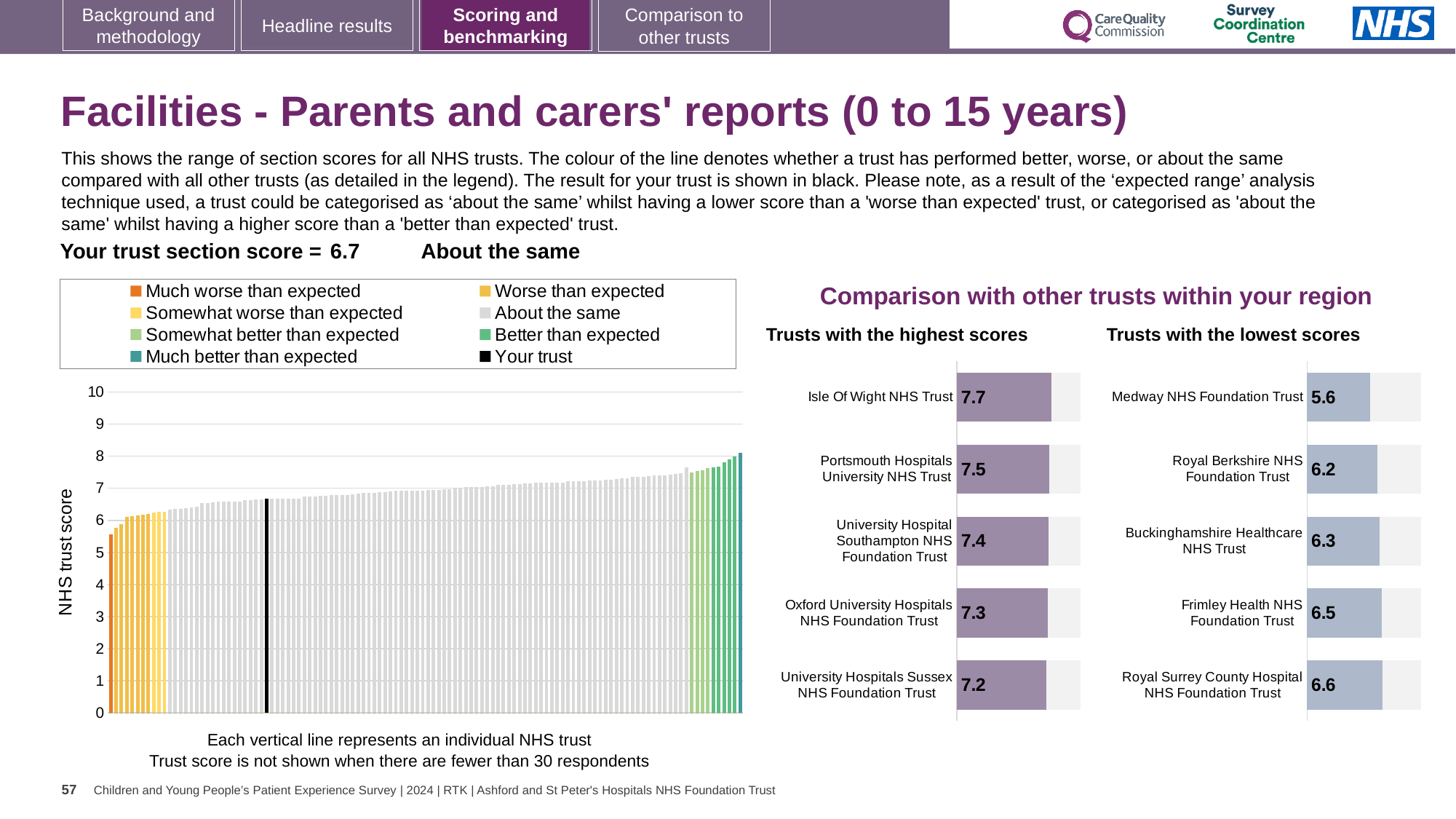
In the large chart on the left showing all NHS trusts, what is the section score for your trust (the black bar)? 6.7 In the 'Trusts with the highest scores' chart, what is the difference between the scores of Isle Of Wight NHS Trust and University Hospitals Sussex NHS Foundation Trust? 0.5 In the 'Trusts with the highest scores' chart, what is the score for Oxford University Hospitals NHS Foundation Trust? 7.3 In the 'Trusts with the lowest scores' chart, which trust has the lowest score? Medway NHS Foundation Trust In the 'Trusts with the highest scores' chart, which trust has the highest score? Isle Of Wight NHS Trust In the 'Trusts with the lowest scores' chart, what is the difference between the scores of Royal Surrey County Hospital NHS Foundation Trust and Medway NHS Foundation Trust? 1.0 In the large chart on the left showing all NHS trusts, is the value of the leftmost (lowest) bar greater or less than 6? less In the 'Trusts with the highest scores' chart, what is the score for Isle Of Wight NHS Trust? 7.7 In the 'Trusts with the lowest scores' chart, what is the score for Medway NHS Foundation Trust? 5.6 In the large chart on the left showing all NHS trusts, do the bar values rise or fall from left to right? rise In the 'Trusts with the lowest scores' chart, which has the higher score: Frimley Health NHS Foundation Trust or Buckinghamshire Healthcare NHS Trust? Frimley Health NHS Foundation Trust How many trusts are listed in the 'Trusts with the lowest scores' chart? 5